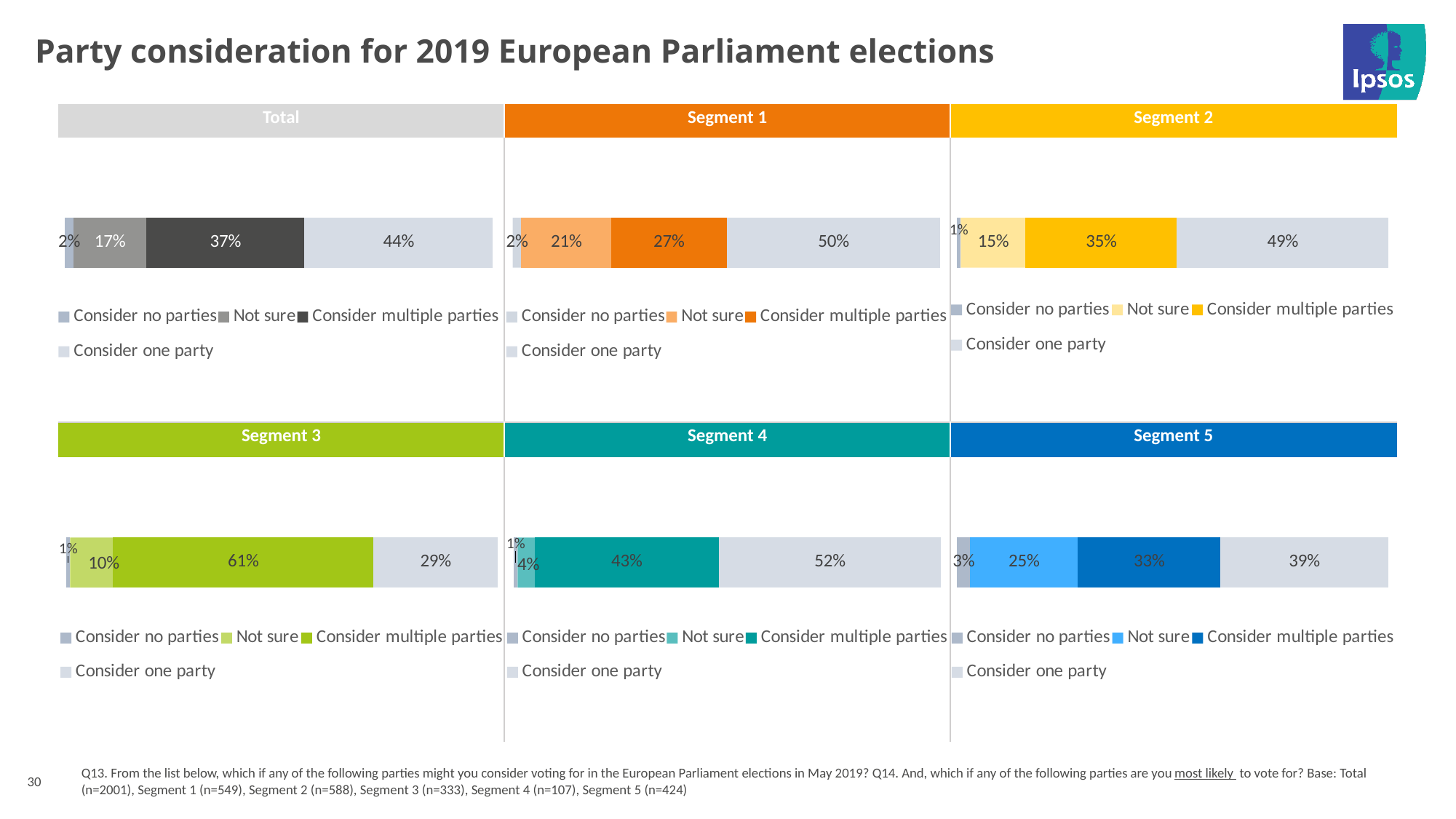
In the Segment 1 chart, what percentage is shown for Consider one party? 50% In the Segment 4 chart, what is the combined share of Not sure and Consider multiple parties? 47% In the Total chart, what is the difference between Consider one party and Consider multiple parties? 7% In the Total chart, what percentage is shown for Consider multiple parties? 37% What kind of chart is used for Segment 5? Stacked bar chart In the Segment 4 chart, which category has the largest share? Consider one party In the Segment 2 chart, which category has the smallest share? Consider no parties In the Segment 3 chart, what percentage is shown for Consider multiple parties? 61% In the Segment 5 chart, what percentage is shown for Not sure? 25% How many series does the legend of the Segment 3 chart list? 4 In the Segment 1 chart, which is larger: Not sure or Consider multiple parties? Consider multiple parties How many separate charts are shown on the slide? 6